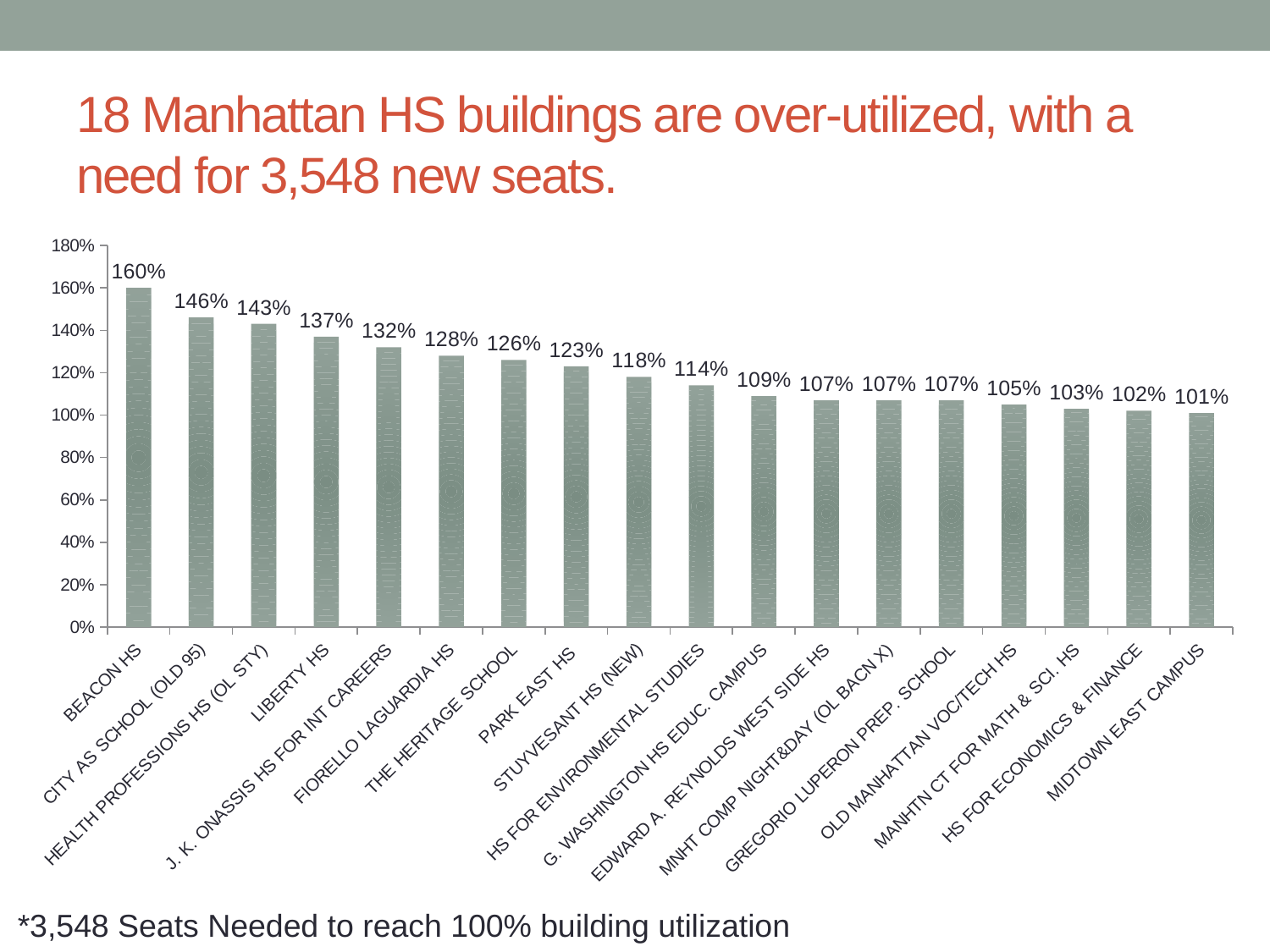
Is the value for FIORELLO LAGUARDIA HS greater or less than 120%? greater What is the utilization value for MIDTOWN EAST CAMPUS? 101% What is the utilization value for LIBERTY HS? 137% Do the values rise or fall from left to right along the x axis? fall What kind of chart is shown on the slide? bar chart Which has a higher utilization, PARK EAST HS or HS FOR ENVIRONMENTAL STUDIES? PARK EAST HS What is the utilization value for STUYVESANT HS (NEW)? 118% How many school buildings are shown in the chart? 18 What is the difference between the utilization of BEACON HS and CITY AS SCHOOL (OLD 95)? 14% What is the utilization value for BEACON HS? 160% Which school building has the lowest utilization? MIDTOWN EAST CAMPUS Which school building has the highest utilization? BEACON HS